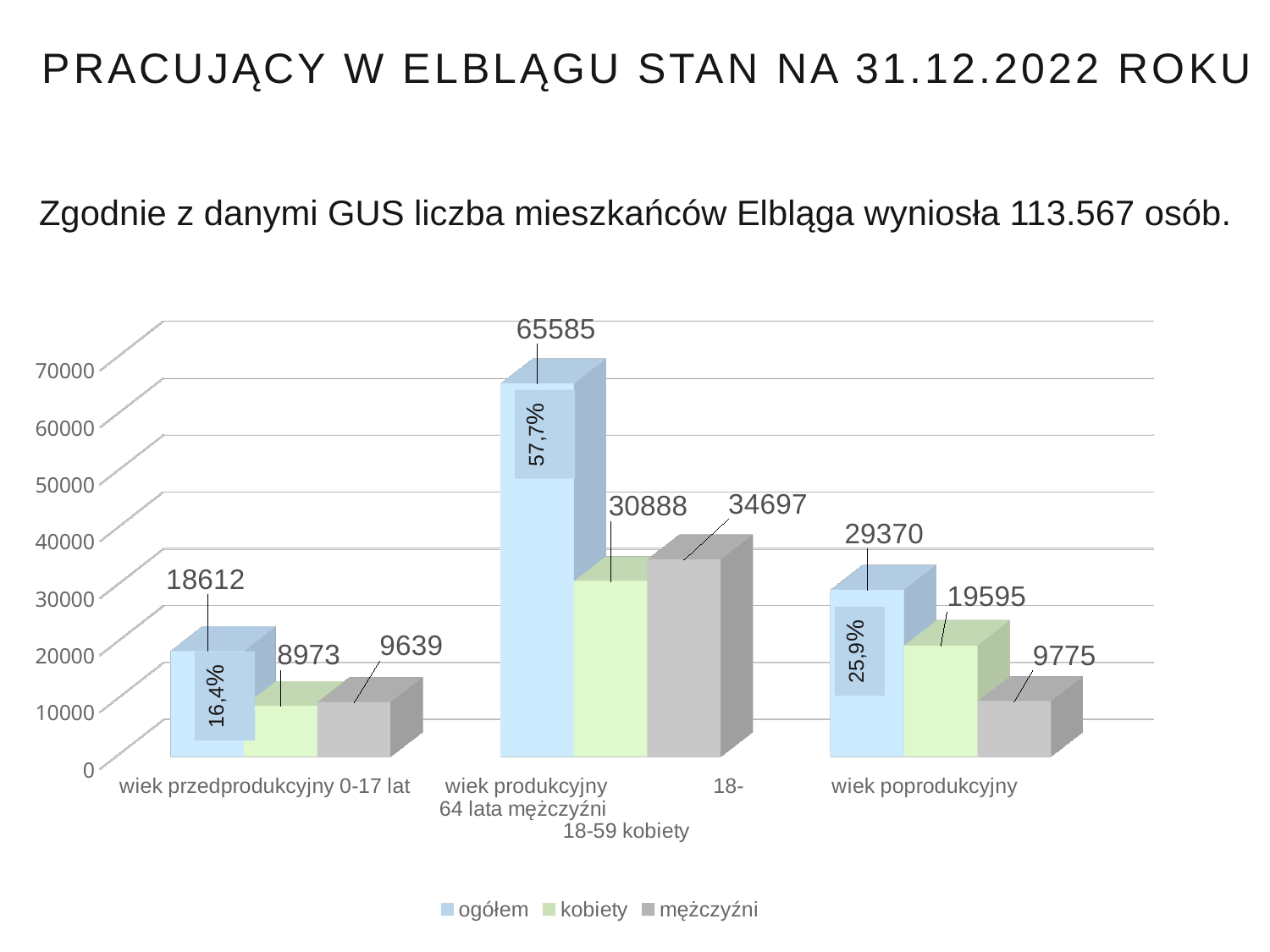
How many categories are shown on the x axis? 3 What kind of chart is shown on the slide? bar chart For wiek poprodukcyjny, which is larger: kobiety or mężczyźni? kobiety How many series does the legend list? 3 What is the difference between mężczyźni and kobiety for wiek produkcyjny? 3809 What is the value of kobiety for wiek przedprodukcyjny 0-17 lat? 8973 What is the value of ogółem for wiek poprodukcyjny? 29370 What percentage is printed on the ogółem bar for wiek produkcyjny? 57,7% Which series is shown in green in the legend? kobiety Which category has the highest ogółem value? wiek produkcyjny What is the value of mężczyźni for wiek produkcyjny? 34697 Which category has the lowest mężczyźni value? wiek przedprodukcyjny 0-17 lat